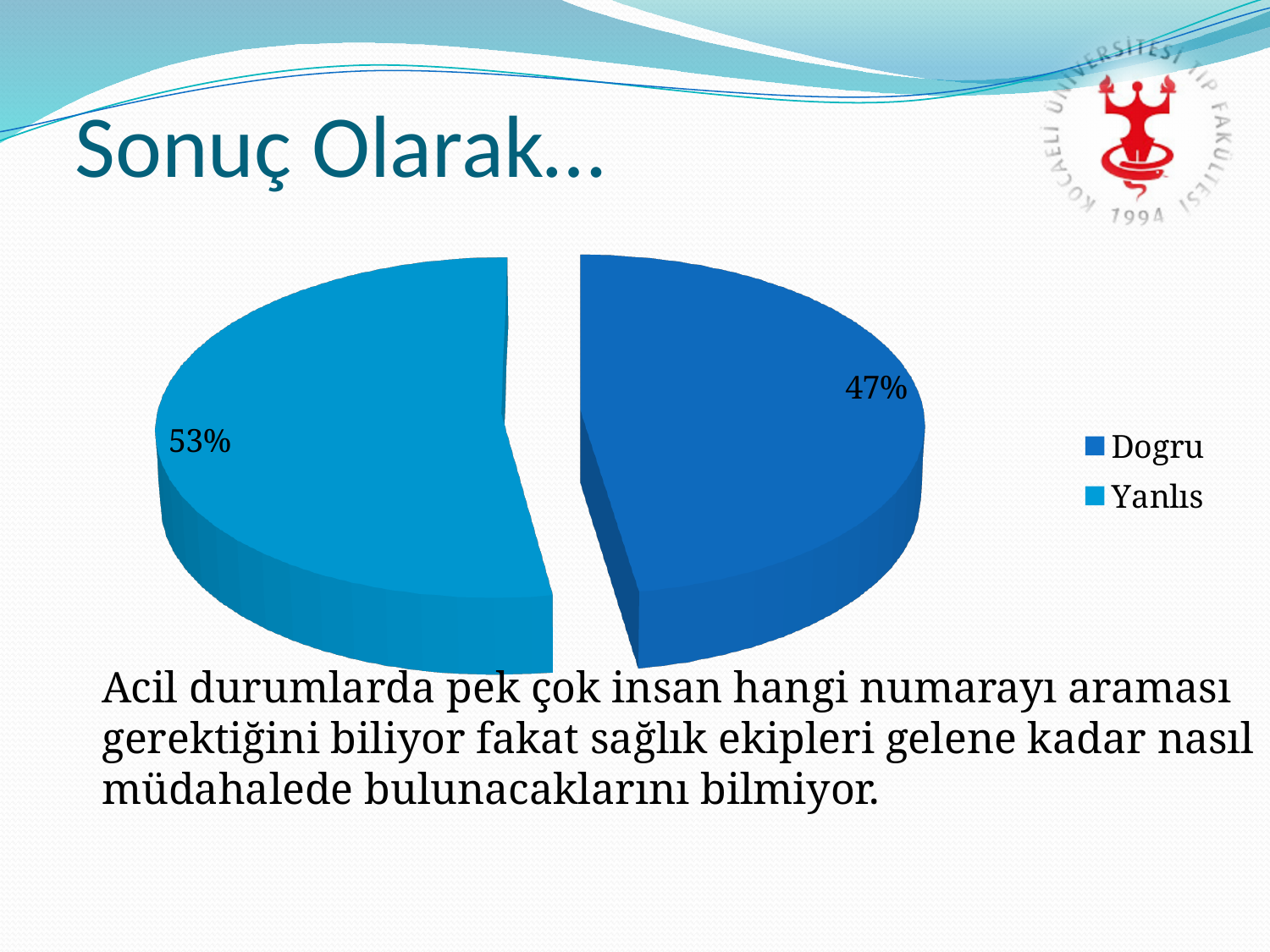
What share of the pie does Dogru represent? 47% Which slice is larger, Dogru or Yanlıs? Yanlıs Which category has the largest slice of the pie? Yanlıs What is the title of the slide containing the pie chart? Sonuç Olarak... How many slices does the pie chart have? 2 What share of the pie does Yanlıs represent? 53% Which category has the smallest slice of the pie? Dogru What kind of chart is shown on the slide? Pie chart What is the difference in percentage points between the Yanlıs and Dogru slices? 6 Is the share for Dogru greater or less than 50%? less How many entries does the legend list? 2 Which legend entry is shown in the lighter blue colour? Yanlıs